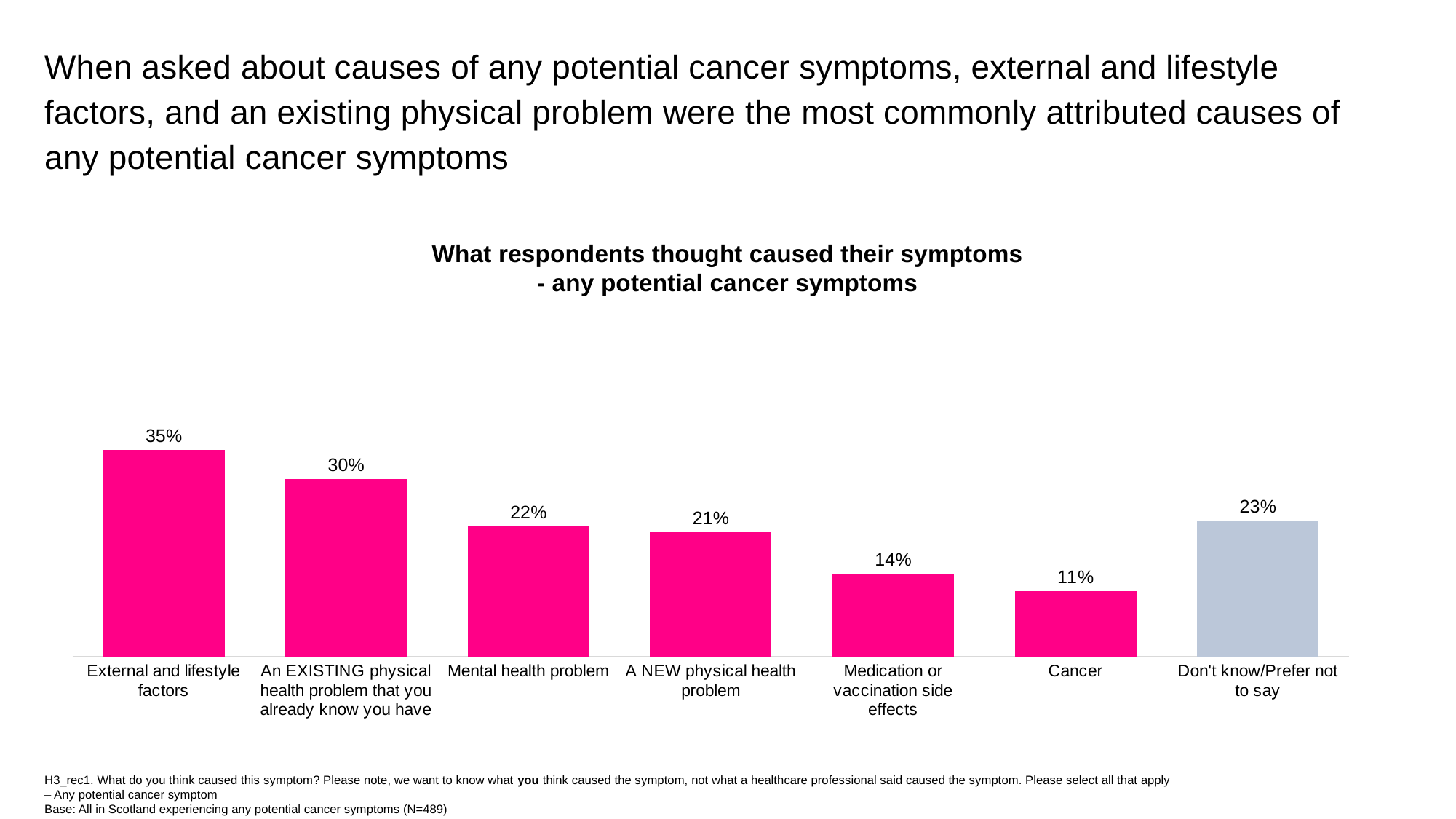
What type of chart is shown on the slide? Bar chart How many categories are shown in the chart? 7 What is the difference between the values for Mental health problem and Cancer? 11% What percentage of respondents answered Don't know/Prefer not to say? 23% Which category has the highest value? External and lifestyle factors Which category has the lowest value? Cancer Which bar is shown in a different colour from the others? Don't know/Prefer not to say What is the difference between the values for External and lifestyle factors and An EXISTING physical health problem that you already know you have? 5% What is the value for Cancer? 11% What is the value for Medication or vaccination side effects? 14% What percentage of respondents attributed their symptoms to external and lifestyle factors? 35% Which is larger: the value for Don't know/Prefer not to say or the value for A NEW physical health problem? Don't know/Prefer not to say